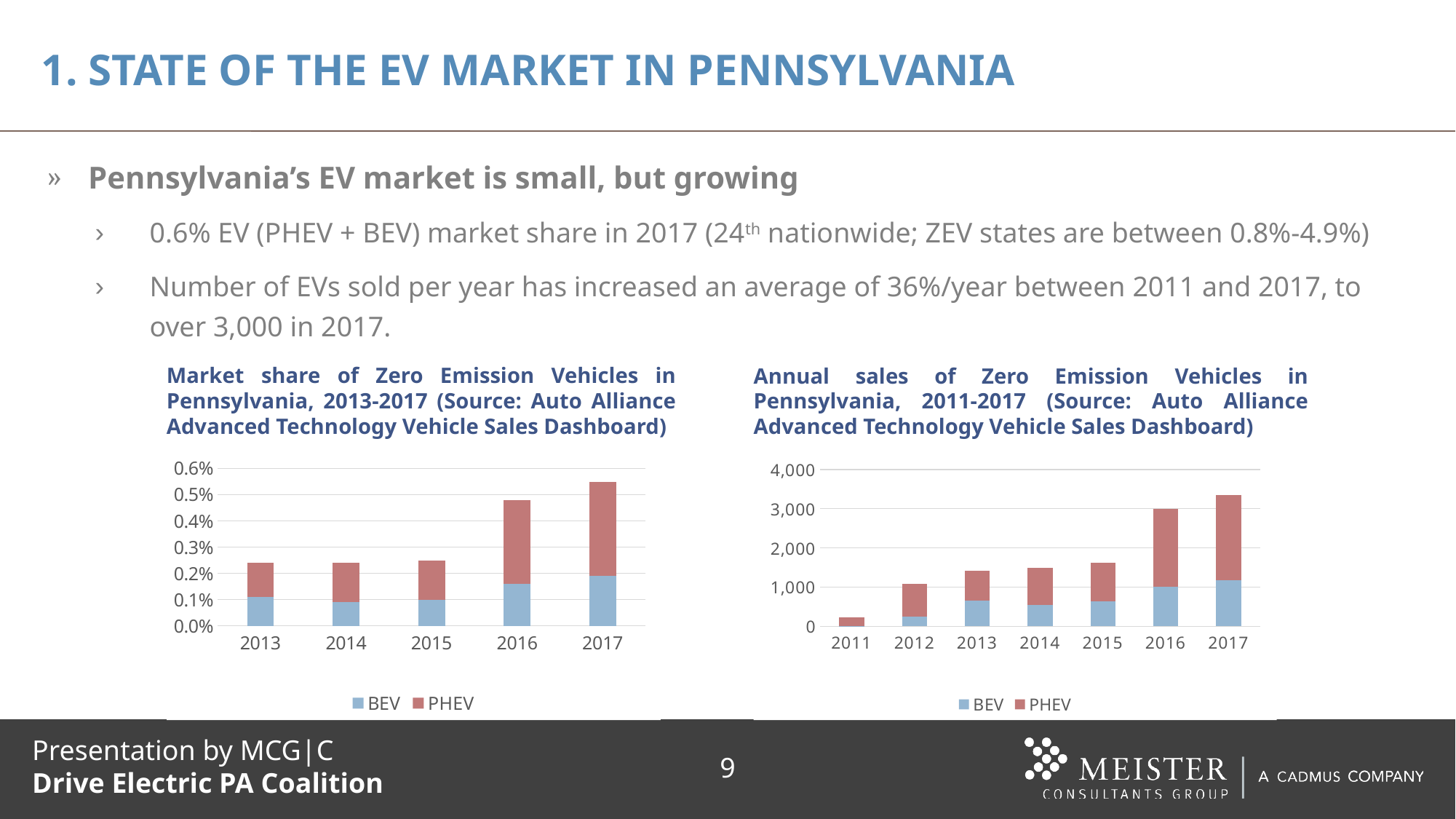
In the right chart on annual sales of Zero Emission Vehicles, is the total for 2017 greater or less than 3,000? greater How many series does the legend list in the left chart on market share of Zero Emission Vehicles? 2 How many years are shown on the x axis of the 'Annual sales of Zero Emission Vehicles in Pennsylvania, 2011-2017' chart on the right? 7 In the right chart on annual sales of Zero Emission Vehicles, which year has higher total sales, 2015 or 2016? 2016 In the right chart on annual sales of Zero Emission Vehicles, which year has the highest total sales? 2017 Which series is shown in red in the legend of the left chart on market share of Zero Emission Vehicles? PHEV What kind of chart is the 'Market share of Zero Emission Vehicles in Pennsylvania, 2013-2017' chart on the left? Stacked bar chart In the left chart on market share of Zero Emission Vehicles, is the total market share for 2013 greater or less than 0.3%? less In the left chart on market share of Zero Emission Vehicles, which year has the highest total market share? 2017 In the right chart on annual sales of Zero Emission Vehicles, is the total for 2011 greater or less than 1,000? less In the right chart on annual sales of Zero Emission Vehicles, which year has the lowest total sales? 2011